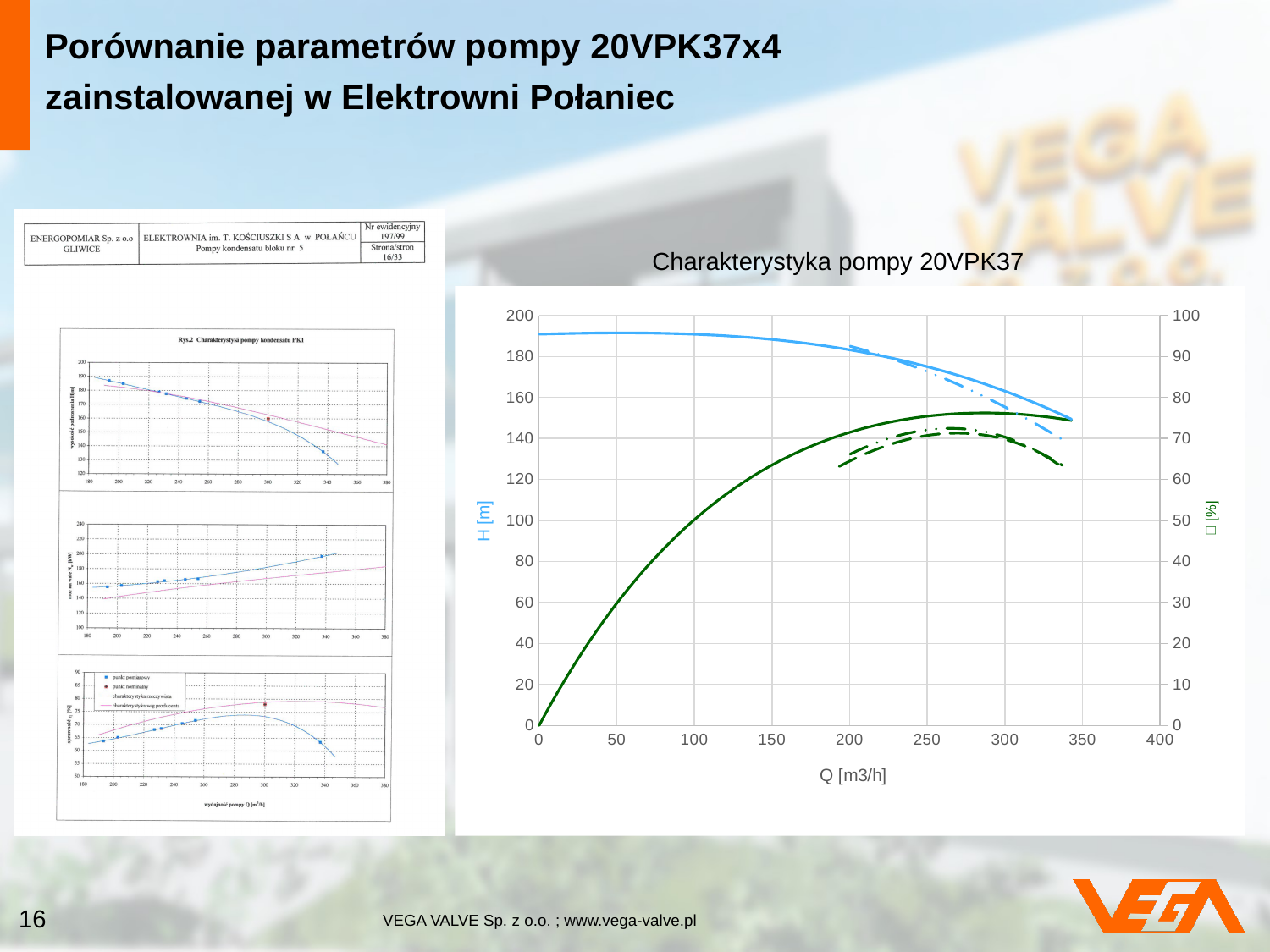
What kind of chart is 'Charakterystyka pompy 20VPK37'? line chart What is the label of the x axis of the chart 'Charakterystyka pompy 20VPK37'? Q [m3/h] In the chart 'Charakterystyka pompy 20VPK37', is the value of the green solid line at Q = 50 greater or less than 40 on the [%] axis? less What is the label of the left y axis of the chart 'Charakterystyka pompy 20VPK37'? H [m] In the chart 'Charakterystyka pompy 20VPK37', does the green solid line rise or fall between Q = 0 and Q = 250? rise In the chart 'Charakterystyka pompy 20VPK37', is the value of the green solid line at Q = 150 greater or less than 60 on the [%] axis? greater In the chart 'Charakterystyka pompy 20VPK37', does the blue solid line rise or fall as Q increases? fall In the chart 'Charakterystyka pompy 20VPK37', which line is higher at Q = 100, the blue solid line or the green solid line (both read on the left H [m] axis)? blue solid line In the chart 'Charakterystyka pompy 20VPK37', is the peak of the green solid line greater or less than 70 on the [%] axis? greater